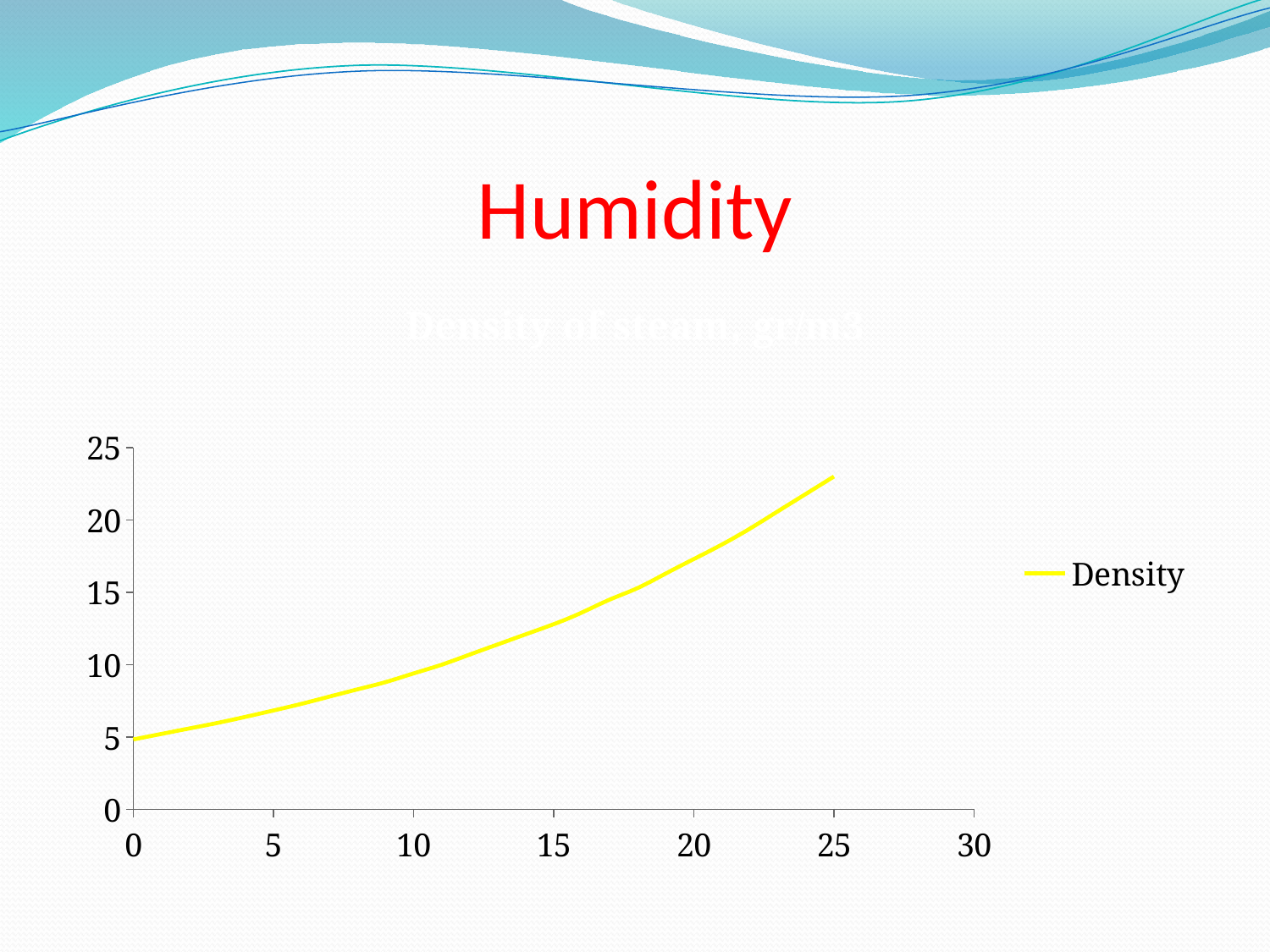
Is the Density value at x = 20 greater or less than 15? greater Is the Density value at x = 15 greater or less than 15? less Is the Density value at x = 5 greater or less than 10? less How many series does the legend list? 1 What is the name of the series shown in the legend? Density What colour is the Density line? yellow Is the Density value at x = 20 larger or smaller than the value at x = 10? larger At which x-axis value is the Density line at its lowest point? 0 Does the Density line rise or fall as the x-axis value increases? rises What kind of chart is shown on the slide? line chart At which x-axis value does the Density line reach its highest point? 25